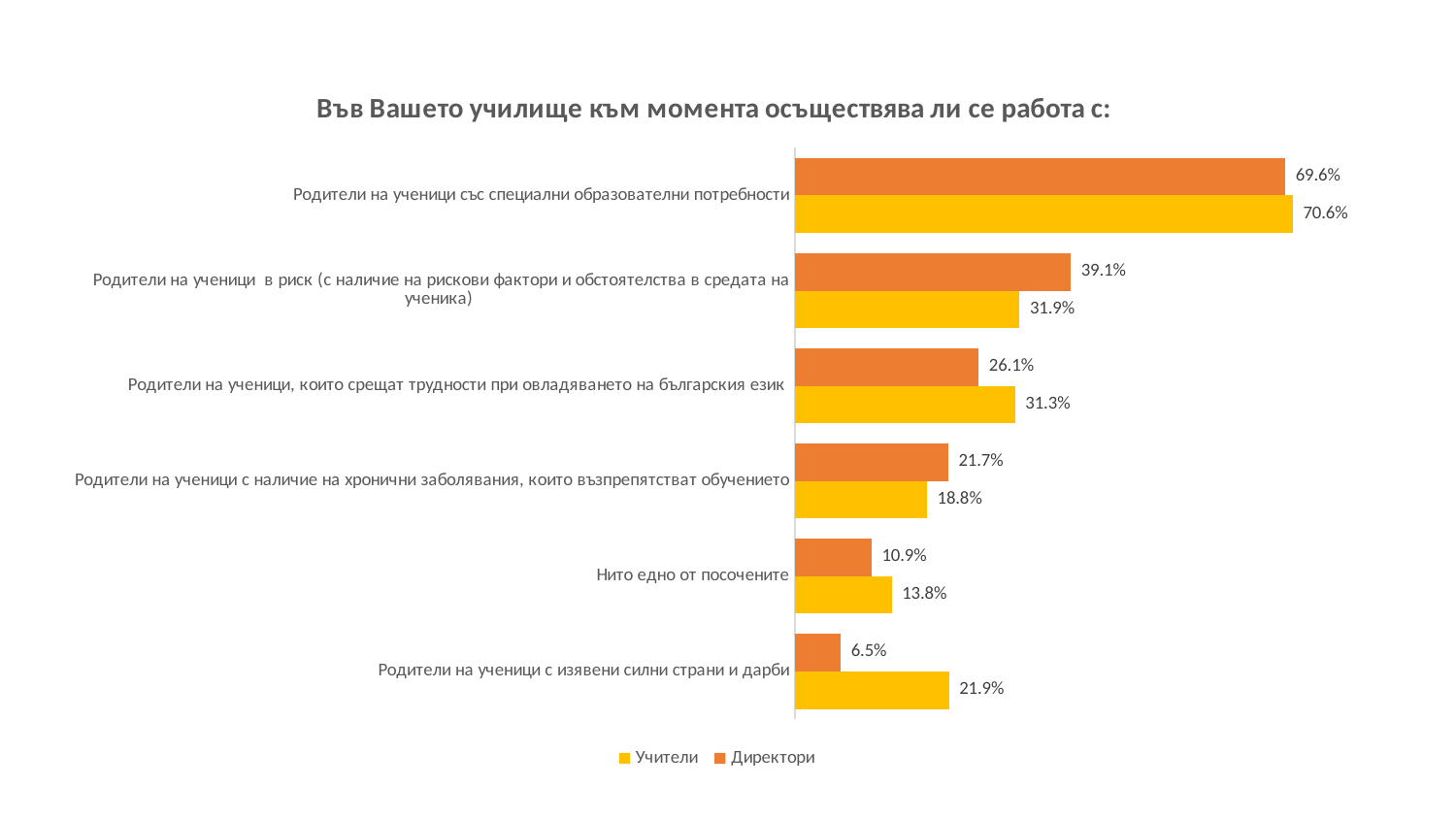
Which category has the highest value for Учители? Родители на ученици със специални образователни потребности What type of chart is shown on the slide? Bar chart What is the value for Учители for 'Родители на ученици с изявени силни страни и дарби'? 21.9% What is the value for Учители for 'Родители на ученици със специални образователни потребности'? 70.6% What is the value for Директори for 'Нито едно от посочените'? 10.9% How many series does the legend list? 2 What is the difference between the Учители and Директори values for 'Родители на ученици с изявени силни страни и дарби'? 15.4% For 'Родители на ученици, които срещат трудности при овладяването на българския език', which series has the larger value, Учители or Директори? Учители Which category has the lowest value for Директори? Родители на ученици с изявени силни страни и дарби For 'Родители на ученици в риск', which series has the larger value, Учители or Директори? Директори What is the value for Директори for 'Родители на ученици в риск'? 39.1% How many categories are shown in the chart? 6